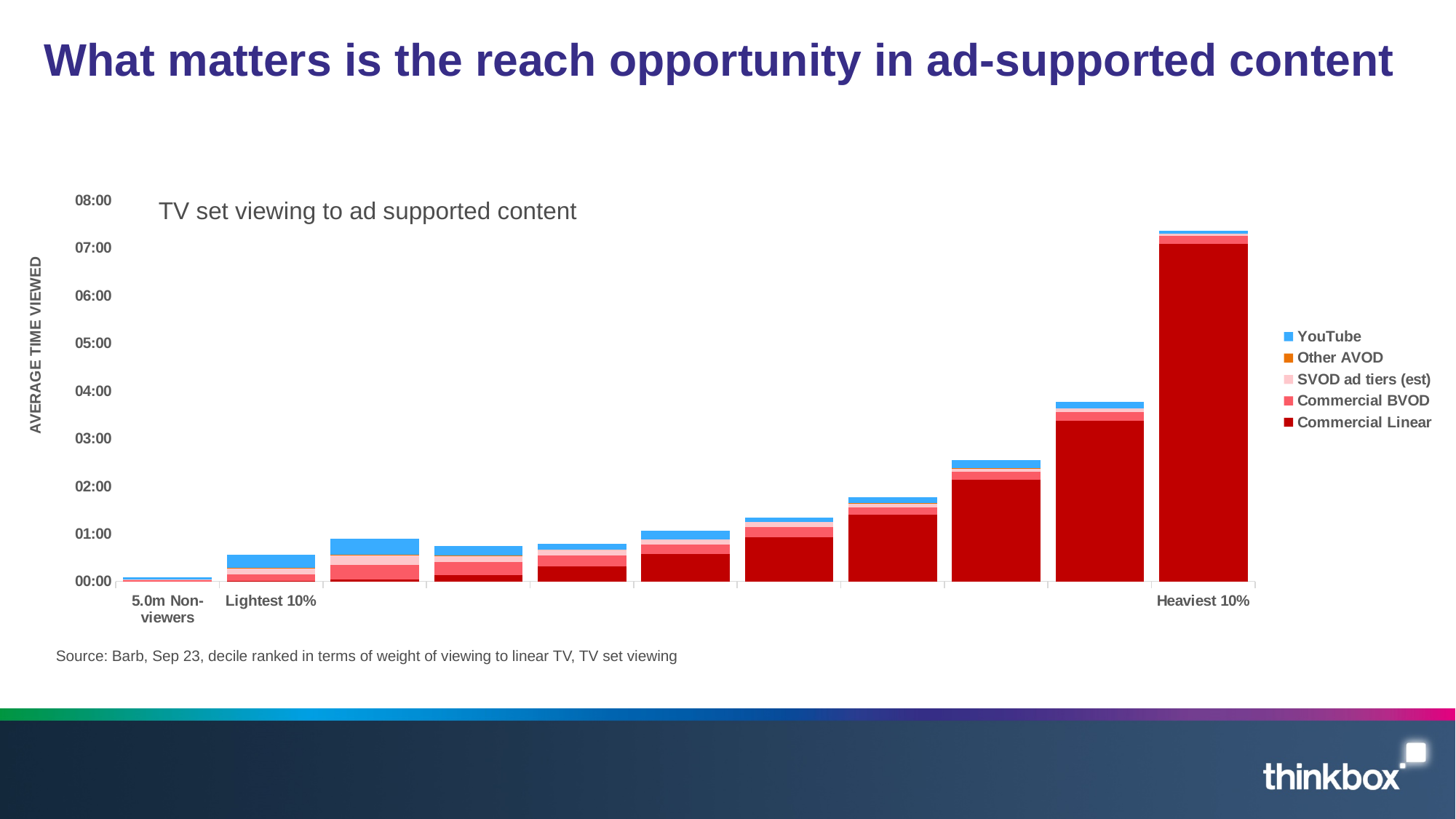
How many series does the legend list? 5 What kind of chart is shown on the slide? Stacked bar chart Is the total value for Heaviest 10% greater or less than 07:00? greater Which category has the lowest total average time viewed? 5.0m Non-viewers Do the bar totals rise or fall moving from left to right along the x axis? Rise Which category has the highest total average time viewed? Heaviest 10% How many bars are plotted in the chart? 11 Which series makes up the largest part of the Heaviest 10% bar? Commercial Linear What is the label on the vertical axis? AVERAGE TIME VIEWED Which has a larger total average time viewed, Lightest 10% or Heaviest 10%? Heaviest 10% Is the total value for Lightest 10% greater or less than 01:00? less What is the title of the chart? TV set viewing to ad supported content